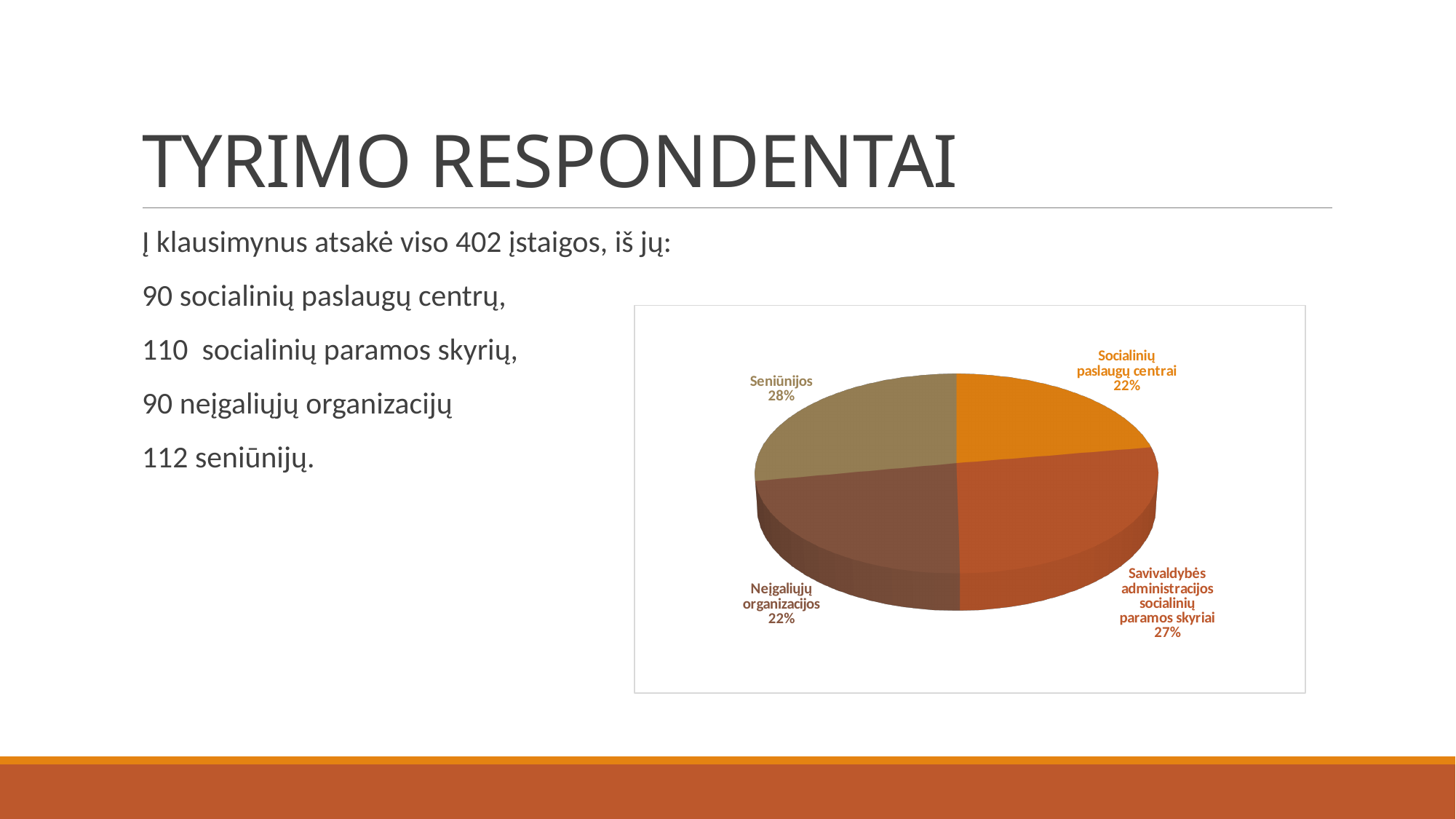
What share of the pie does Socialinių paslaugų centrai represent? 22% What share of the pie does Neįgaliųjų organizacijos represent? 22% Which slice of the pie chart is coloured orange? Socialinių paslaugų centrai Which two slices of the pie chart have the same share? Socialinių paslaugų centrai and Neįgaliųjų organizacijos What kind of chart is shown on the slide? Pie chart Which slice of the pie chart is the largest? Seniūnijos What is the difference in percentage points between the Savivaldybės administracijos socialinių paramos skyriai share and the Socialinių paslaugų centrai share? 5 Which is larger: the share for Seniūnijos or the share for Savivaldybės administracijos socialinių paramos skyriai? Seniūnijos What is the difference in percentage points between the Seniūnijos share and the Neįgaliųjų organizacijos share? 6 How many slices does the pie chart have? 4 What share of the pie does Savivaldybės administracijos socialinių paramos skyriai represent? 27%